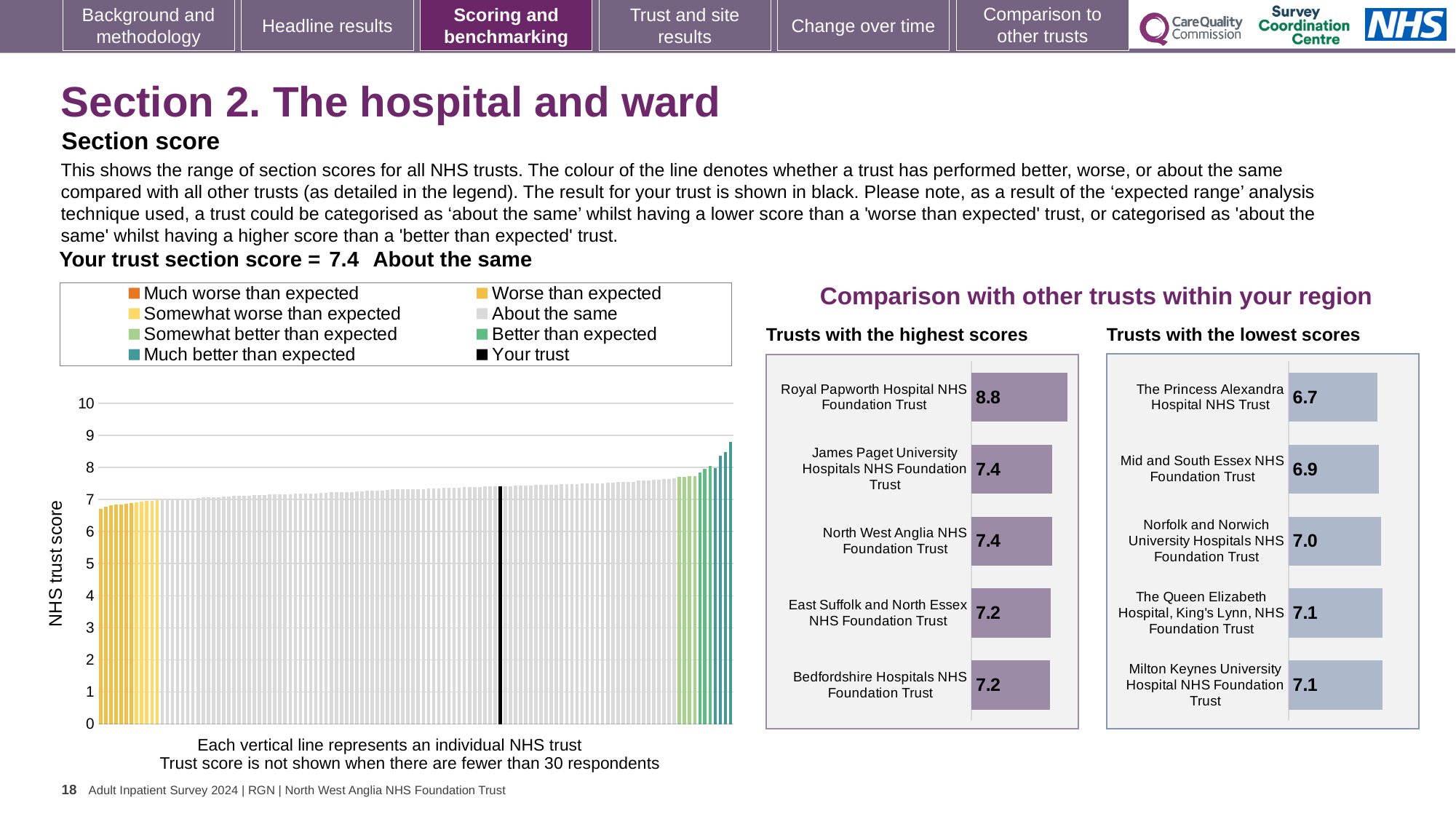
In the 'Trusts with the lowest scores' chart, what is the score for Mid and South Essex NHS Foundation Trust? 6.9 In the main 'NHS trust score' chart on the left, is the value of the tallest bar greater or less than 8? greater In the 'Trusts with the highest scores' chart, which trust has the highest score? Royal Papworth Hospital NHS Foundation Trust What kind of chart is the main 'NHS trust score' chart on the left? bar chart In the 'Trusts with the highest scores' chart, what is the difference between the scores of Royal Papworth Hospital NHS Foundation Trust and Bedfordshire Hospitals NHS Foundation Trust? 1.6 How many entries does the legend of the main 'NHS trust score' chart on the left list? 8 According to the slide, what is your trust's section score shown in the main chart on the left? 7.4 How many trusts are shown in the 'Trusts with the highest scores' chart? 5 In the 'Trusts with the lowest scores' chart, which has the higher score: Norfolk and Norwich University Hospitals NHS Foundation Trust or The Princess Alexandra Hospital NHS Trust? Norfolk and Norwich University Hospitals NHS Foundation Trust In the 'Trusts with the highest scores' chart, what is the score for Royal Papworth Hospital NHS Foundation Trust? 8.8 In the 'Trusts with the lowest scores' chart, what is the difference between the scores of Milton Keynes University Hospital NHS Foundation Trust and The Princess Alexandra Hospital NHS Trust? 0.4 In the 'Trusts with the lowest scores' chart, which trust has the lowest score? The Princess Alexandra Hospital NHS Trust